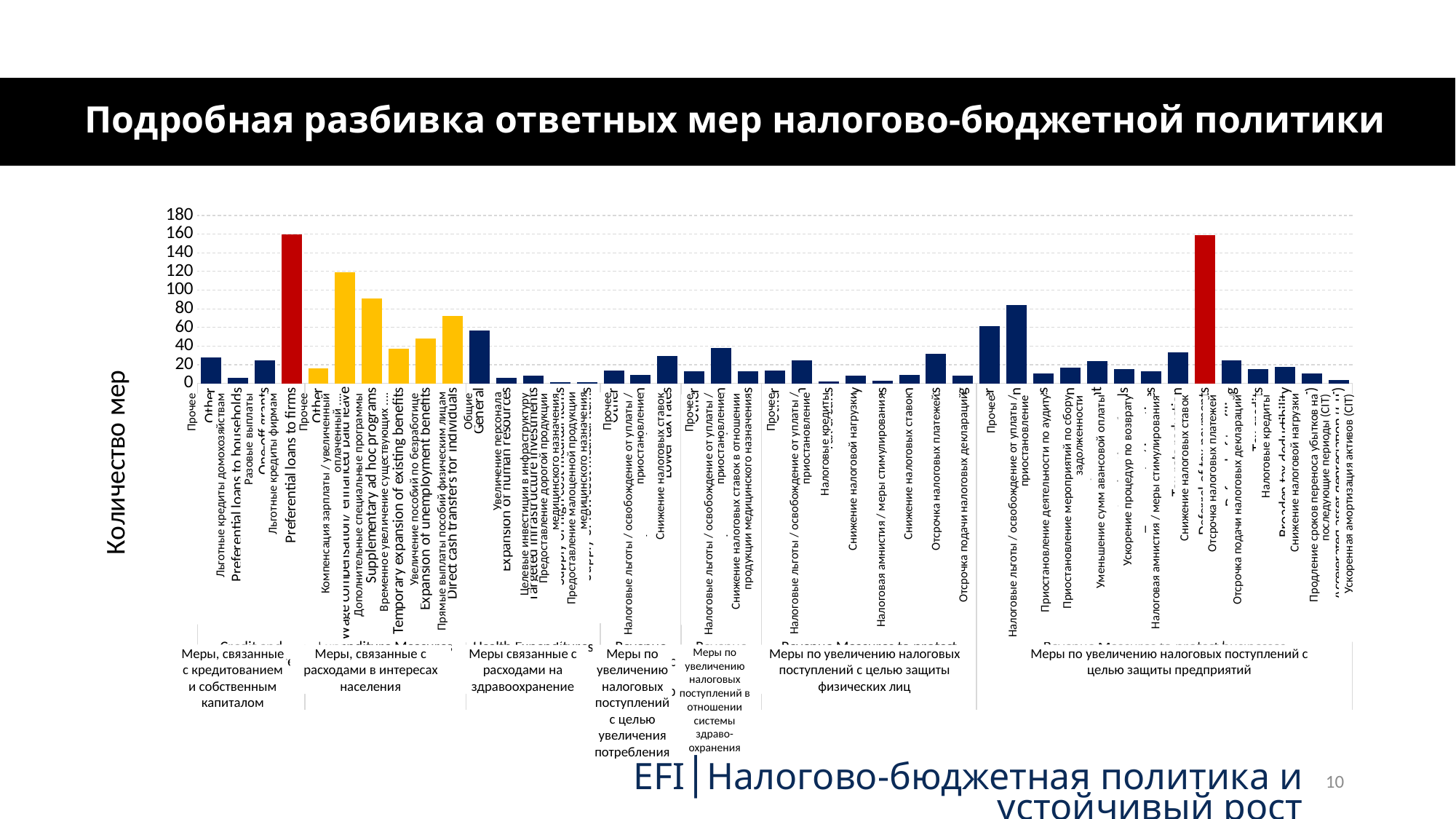
Is the value for Льготные кредиты фирмам greater or less than 140? greater Which is larger: the value for Прямые выплаты пособий физическим лицам or the value for Увеличение пособий по безработице? Прямые выплаты пособий физическим лицам What kind of chart is shown on the slide? bar chart How many category groups are labelled along the bottom of the chart? 7 Is the value for Увеличение пособий по безработице greater or less than 60? less What is the label of the vertical axis? Количество мер Which is larger: the value for Компенсация зарплаты or the value for Дополнительные специальные программы? Компенсация зарплаты Is the value for Отсрочка налоговых платежей (in the group Меры по увеличению налоговых поступлений с целью защиты предприятий) greater or less than 140? greater What colour are the two tallest bars in the chart? red Among the yellow bars in the group Меры, связанные с расходами в интересах населения, which category has the highest value? Компенсация зарплаты